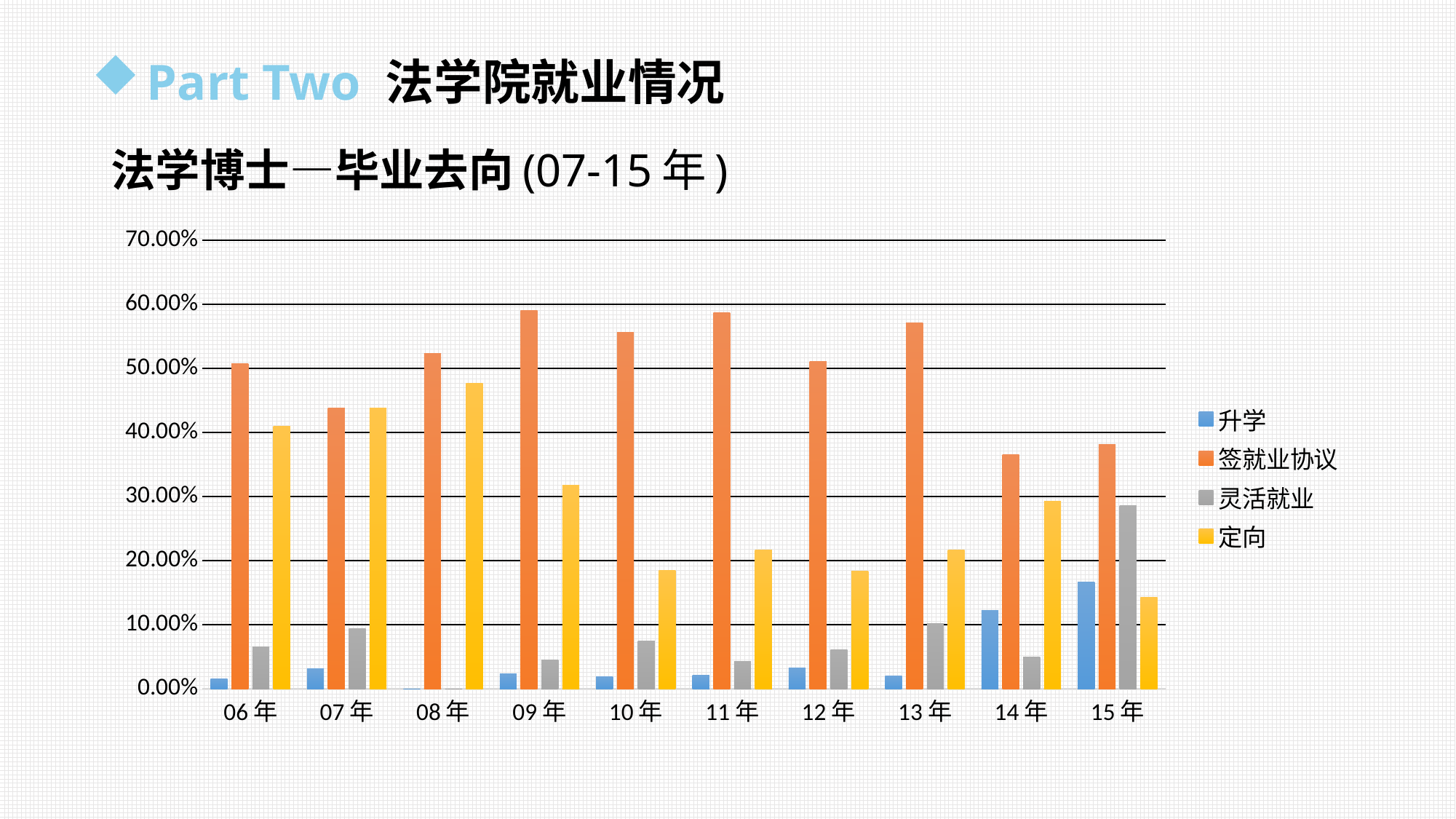
In which year is the value for 升学 the highest? 15年 Is the value for 签就业协议 in 09年 greater or less than 50.00%? greater What kind of chart is shown on the slide? bar chart How many year categories are shown on the x axis? 10 In which year is the value for 灵活就业 the highest? 15年 How many series does the legend list? 4 Is the value for 灵活就业 in 15年 greater or less than 20.00%? greater Does the value for 升学 rise or fall from 13年 to 15年? rise In which year is the value for 定向 the lowest? 15年 Is the value for 签就业协议 in 14年 greater or less than 40.00%? less In which year is the value for 定向 the highest? 08年 In 15年, which is larger: 灵活就业 or 定向? 灵活就业